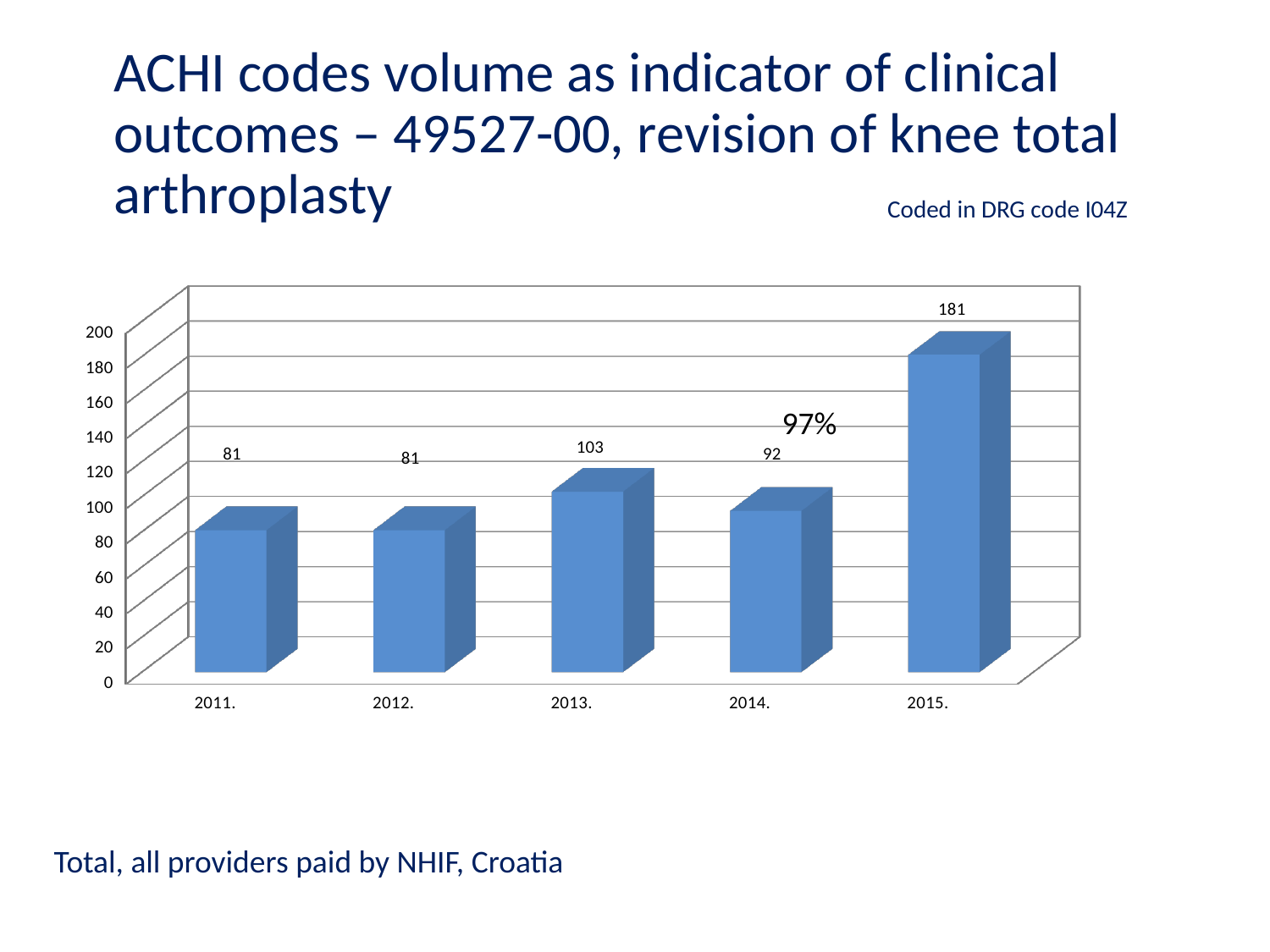
Is the value for 2015 greater or less than 160? greater What is the value for 2011? 81 What kind of chart is shown on the slide? bar chart What is the value for 2013? 103 What is the value for 2014? 92 What is the value for 2015? 181 What is the difference between the values for 2015 and 2014? 89 How many years are shown on the x axis? 5 Which year has the highest value? 2015. What percentage annotation is printed above the 2014 bar? 97% Which is larger, the value for 2013 or the value for 2014? 2013. What is the difference between the values for 2013 and 2012? 22